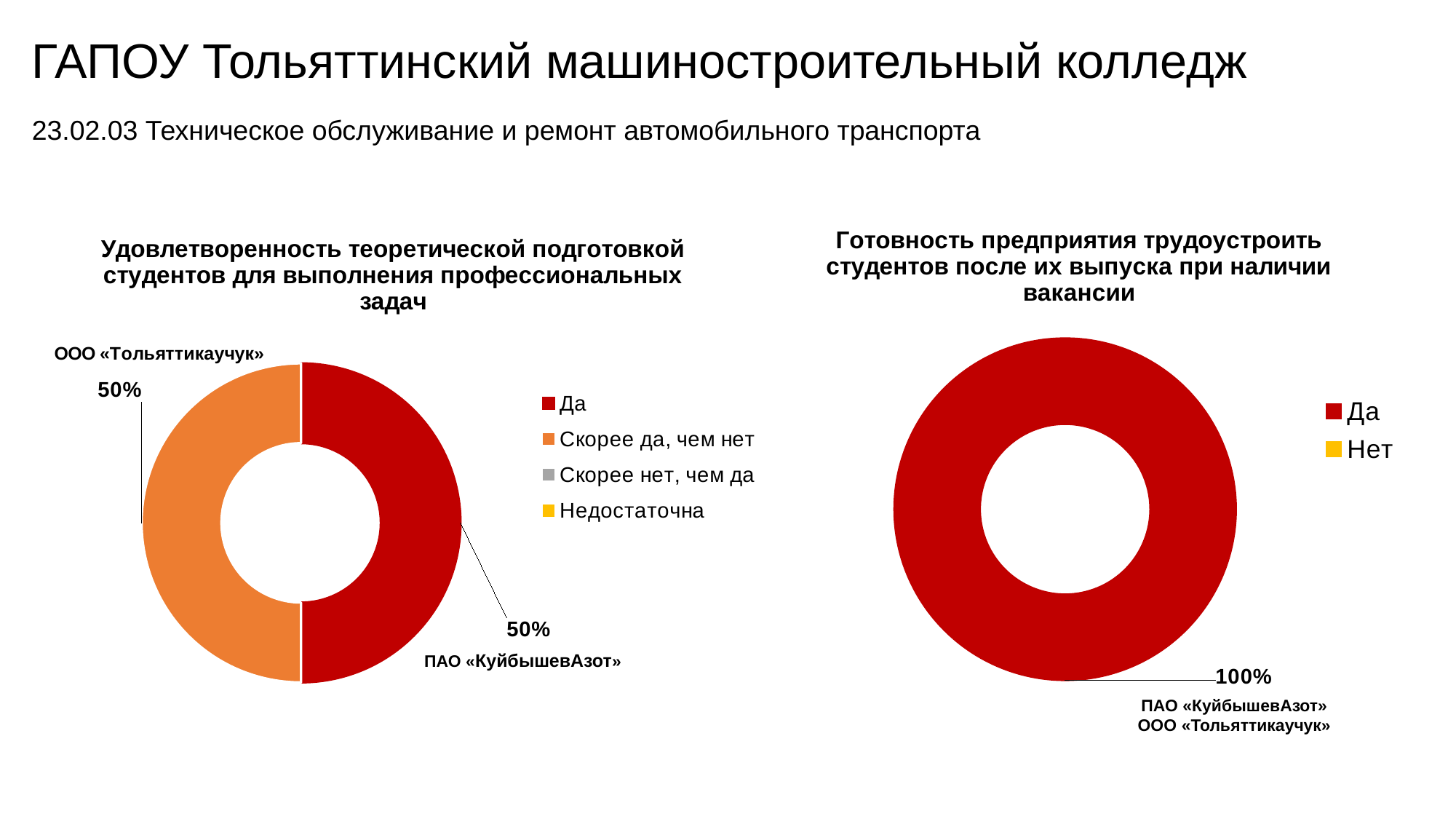
In the right chart ("Готовность предприятия трудоустроить студентов..."), which category has the largest share? Да In the left chart ("Удовлетворенность теоретической подготовкой..."), which legend entry is shown in orange? Скорее да, чем нет What kind of chart is the right chart, titled "Готовность предприятия трудоустроить студентов после их выпуска при наличии вакансии"? Doughnut chart In the right chart ("Готовность предприятия трудоустроить студентов..."), which legend entry is shown in yellow? Нет In the left chart ("Удовлетворенность теоретической подготовкой..."), what share is labelled for "Скорее да, чем нет" (ООО «Тольяттикаучук»)? 50% How many entries does the legend of the left chart ("Удовлетворенность теоретической подготовкой...") list? 4 What kind of chart is the left chart, titled "Удовлетворенность теоретической подготовкой студентов для выполнения профессиональных задач"? Doughnut chart In the left chart ("Удовлетворенность теоретической подготовкой..."), what is the difference between the share for "Да" and the share for "Скорее да, чем нет"? 0% In the left chart ("Удовлетворенность теоретической подготовкой..."), what share is labelled for "Да" (ПАО «КуйбышевАзот»)? 50% In the right chart ("Готовность предприятия трудоустроить студентов..."), what share is labelled for "Да"? 100% How many entries does the legend of the right chart ("Готовность предприятия трудоустроить студентов...") list? 2 In the left chart ("Удовлетворенность теоретической подготовкой..."), how many slices are visible in the doughnut? 2